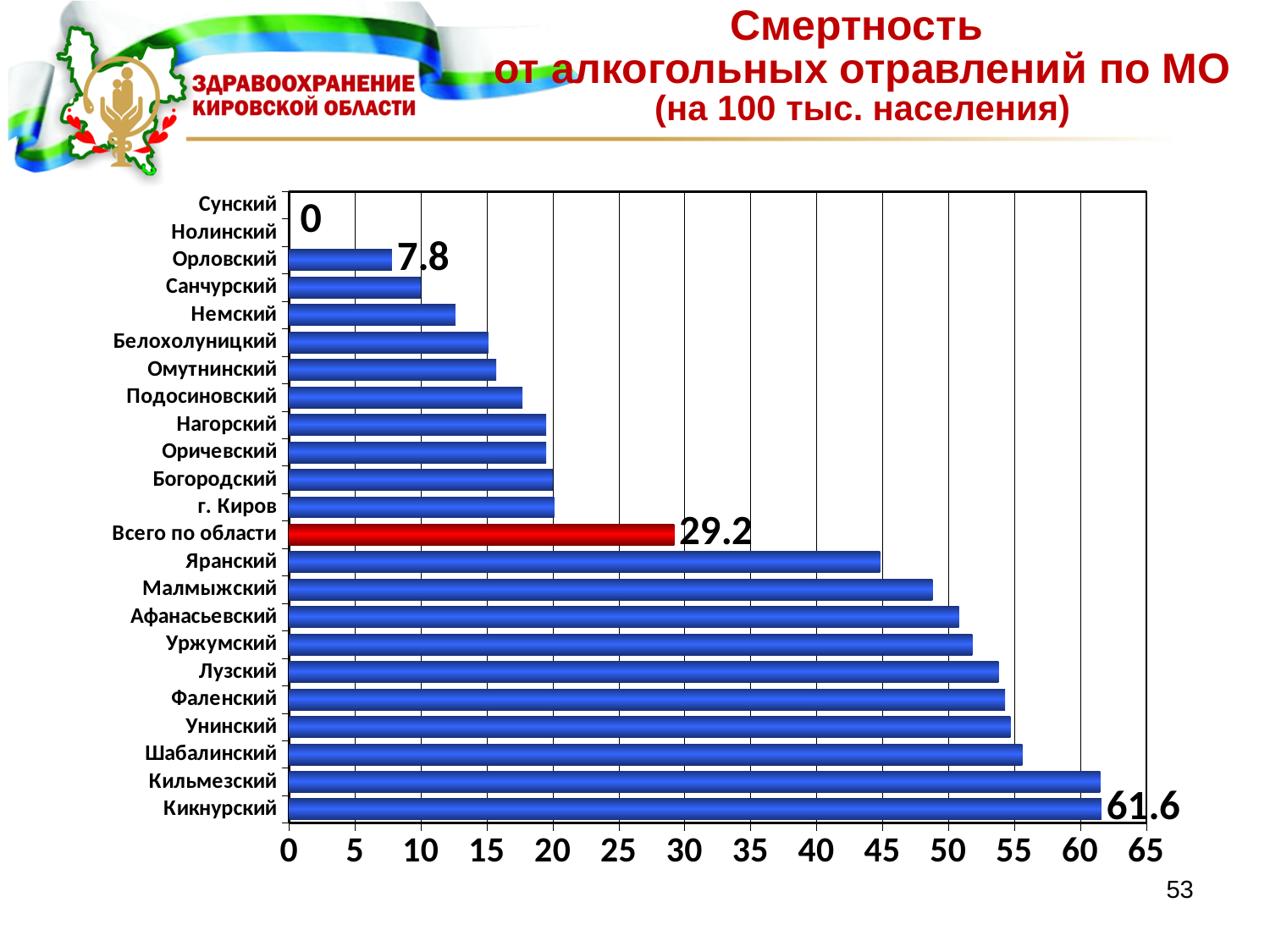
What is the value for Всего по области? 29.2 Which is larger, the value for Кильмезский or the value for Шабалинский? Кильмезский What is the difference between the values for Всего по области and Орловский? 21.4 Is the value for Яранский greater or less than 40? greater What is the difference between the values for Кикнурский and Всего по области? 32.4 What is the value for Кикнурский? 61.6 Which category has the highest value? Кикнурский What kind of chart is shown on the slide? bar chart Is the value for Немский greater or less than 15? less What is the value for Орловский? 7.8 How many categories are shown on the chart? 23 What is the value for Сунский? 0